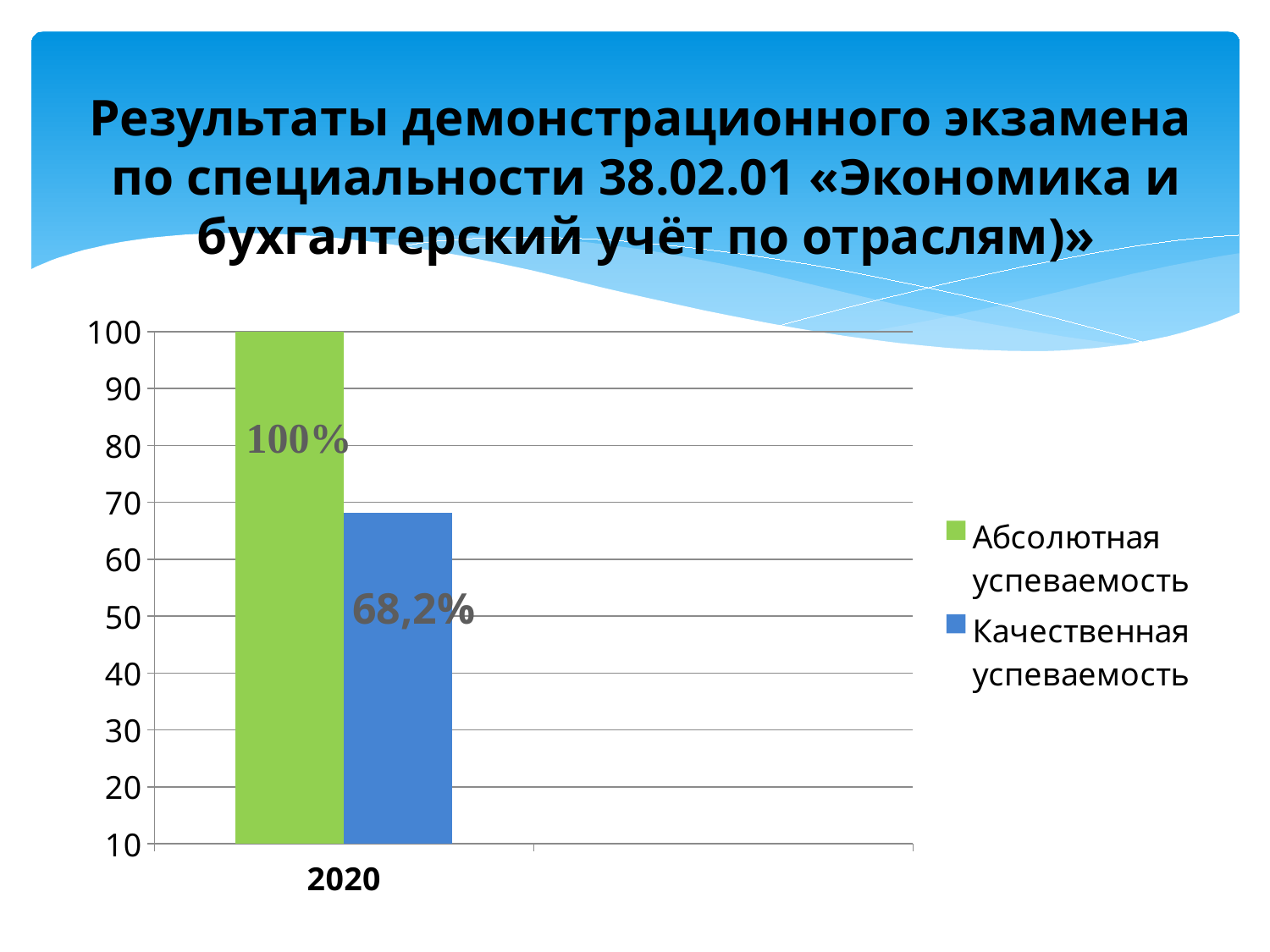
What is the value of Абсолютная успеваемость for 2020? 100% Which year is shown on the x axis of the chart? 2020 What kind of chart is shown on the slide? bar chart What colour is the bar for Качественная успеваемость? blue Which series has the higher value for 2020, Абсолютная успеваемость or Качественная успеваемость? Абсолютная успеваемость How many series does the legend list? 2 How many categories are shown on the x axis? 1 What is the value of Качественная успеваемость for 2020? 68,2% Is the value for Качественная успеваемость in 2020 greater or less than 70? less Which series has the lowest value on the chart? Качественная успеваемость Is the value for Качественная успеваемость in 2020 greater or less than 60? greater What is the difference between Абсолютная успеваемость and Качественная успеваемость for 2020? 31,8%